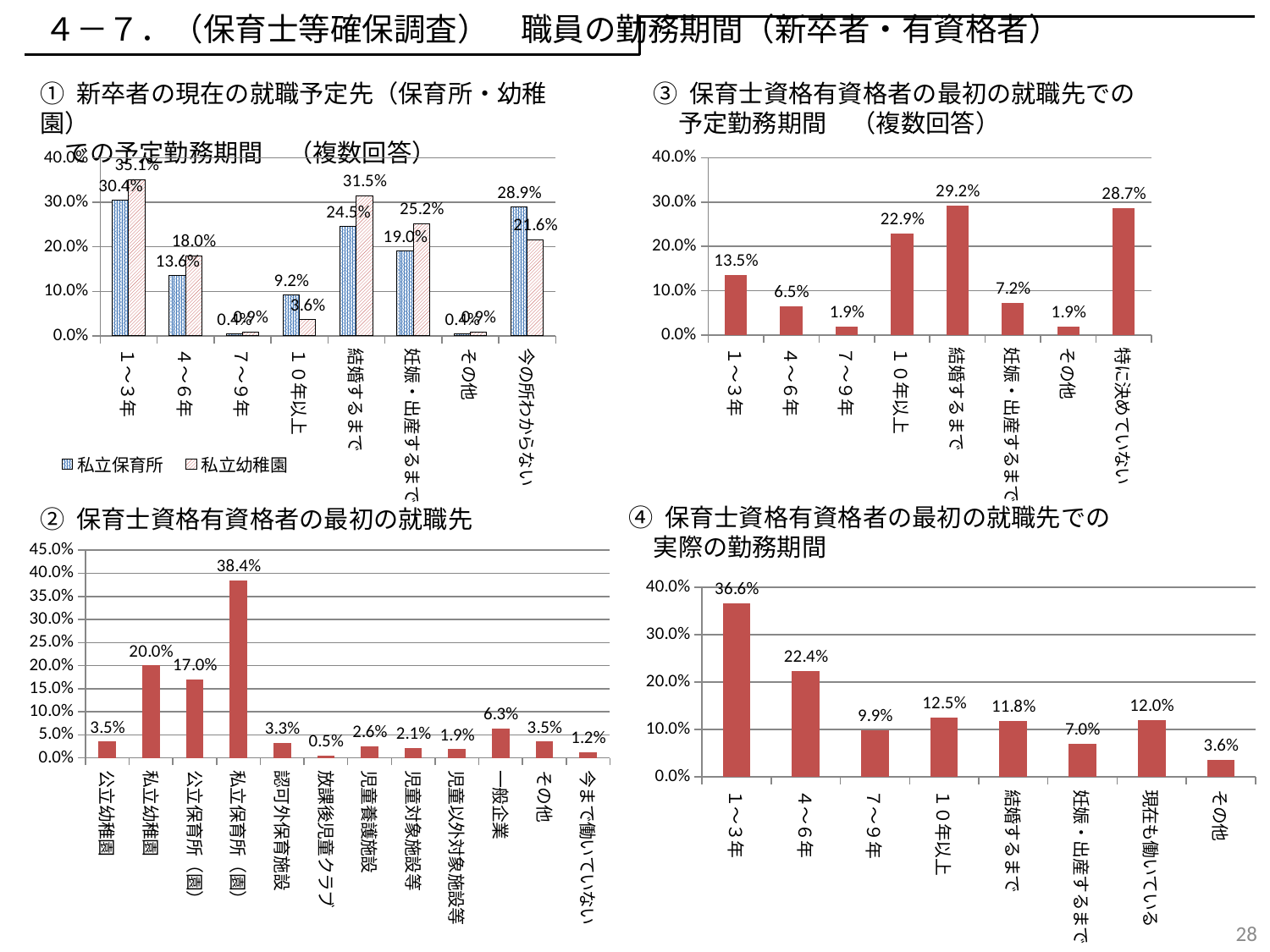
In chart ② (保育士資格有資格者の最初の就職先), how many categories are shown on the x axis? 12 In chart ① (新卒者の現在の就職予定先での予定勤務期間), how many series does the legend list? 2 In chart ③ (保育士資格有資格者の最初の就職先での予定勤務期間), what is the value for １０年以上? 22.9% In chart ③ (保育士資格有資格者の最初の就職先での予定勤務期間), which is larger: 結婚するまで or 特に決めていない? 結婚するまで In chart ④ (保育士資格有資格者の最初の就職先での実際の勤務期間), what is the difference between １～３年 and ４～６年? 14.2% In chart ② (保育士資格有資格者の最初の就職先), which category has the lowest value? 放課後児童クラブ In chart ① (新卒者の現在の就職予定先での予定勤務期間), what is the value of 私立幼稚園 for 結婚するまで? 31.5% In chart ② (保育士資格有資格者の最初の就職先), what is the value for 私立保育所（園）? 38.4% In chart ② (保育士資格有資格者の最初の就職先), what is the difference between 私立幼稚園 and 公立保育所（園）? 3.0% In chart ④ (保育士資格有資格者の最初の就職先での実際の勤務期間), what is the value for １～３年? 36.6% In chart ③ (保育士資格有資格者の最初の就職先での予定勤務期間), which category has the highest value? 結婚するまで In chart ④ (保育士資格有資格者の最初の就職先での実際の勤務期間), is the value for 現在も働いている greater or less than 10.0%? greater